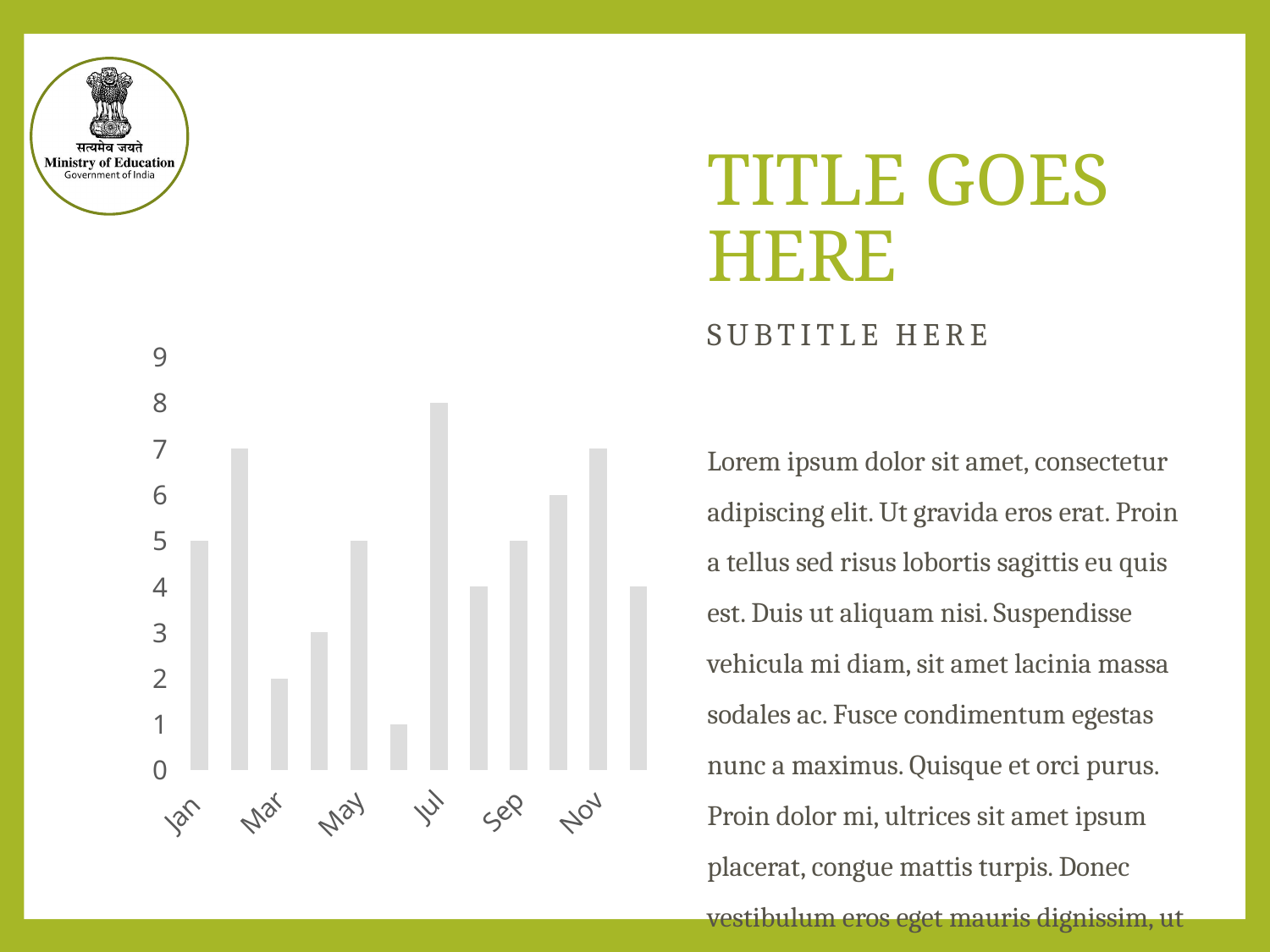
What is the highest value shown on the vertical axis? 9 What is the difference between the values for Jul and Mar? 6 What is the value for Nov? 7 What is the value for Mar? 2 Which is larger, the value for Jul or the value for Nov? Jul Which labelled month has the highest bar? Jul What is the value for Jul? 8 How many bars does the chart contain? 12 Is the value for Mar greater or less than 4? less Is the value for Sep greater or less than 3? greater What is the value for Jan? 5 What kind of chart is shown on the slide? bar chart